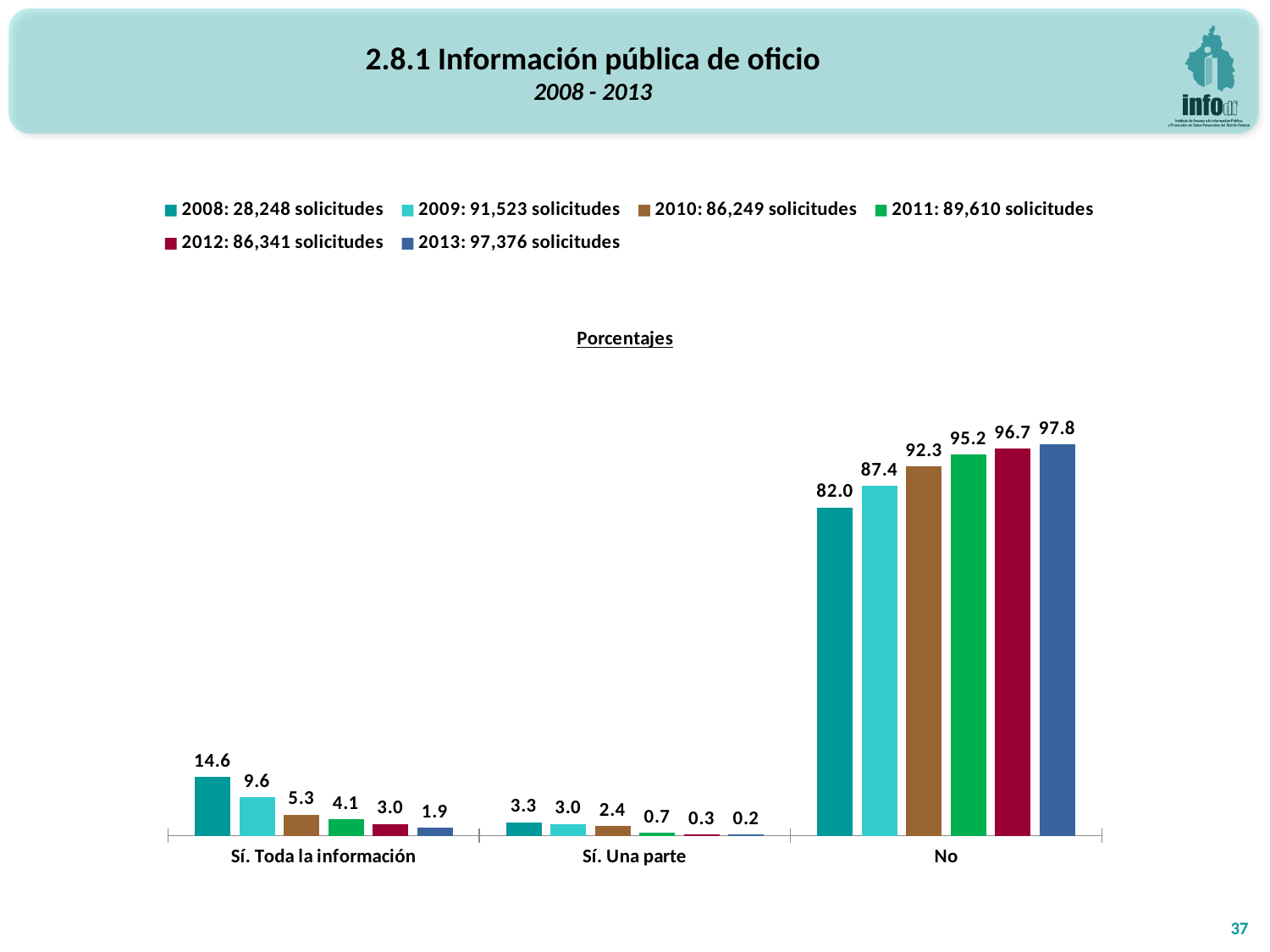
How many categories are shown on the x axis? 3 How many series does the legend list? 6 Which year has the lowest value in the 'Sí. Una parte' category? 2013 What is the value for 2013 in the 'Sí. Toda la información' category? 1.9 Which year has the highest value in the 'No' category? 2013 What kind of chart is shown on the slide? Bar chart What is the difference between the 2013 and 2008 values in the 'No' category? 15.8 Which is larger: the 2009 value or the 2010 value in the 'Sí. Toda la información' category? 2009 According to the legend, how many solicitudes were there in 2013? 97,376 What is the value for 2008 in the 'No' category? 82.0 Do the values for the 'No' category rise or fall from 2008 to 2013? Rise What is the value for 2010 in the 'Sí. Una parte' category? 2.4